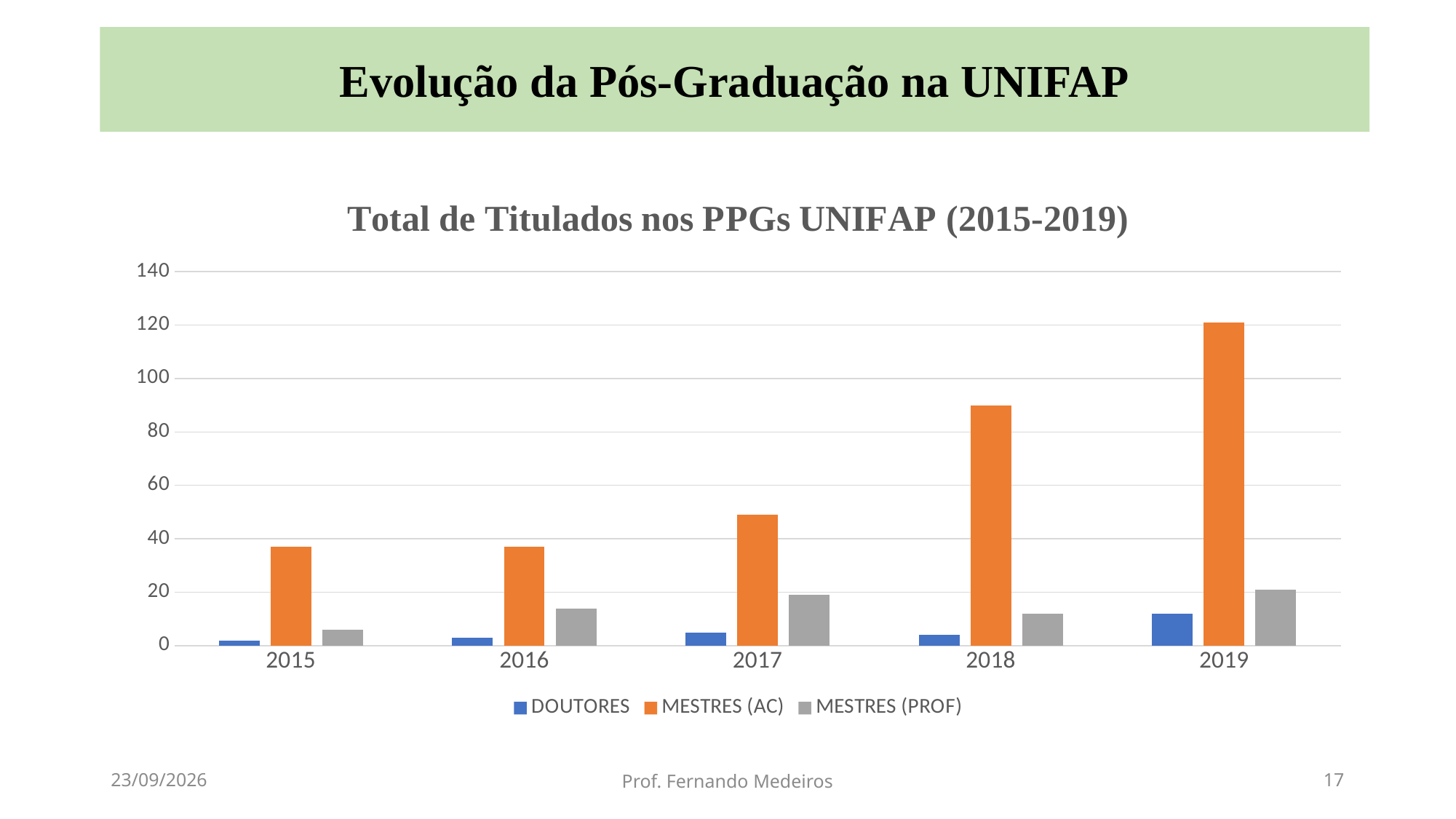
How many years are shown on the x axis of the chart? 5 In which year is the MESTRES (PROF) value lowest? 2015 How many series does the chart's legend list? 3 Do the MESTRES (AC) values generally rise or fall from 2015 to 2019? rise In which year is the MESTRES (AC) value highest? 2019 In which year is the DOUTORES value highest? 2019 Is the DOUTORES value for 2019 greater or less than 20? less What kind of chart is shown on the slide? bar chart Is the MESTRES (AC) value for 2019 greater or less than 100? greater Is the MESTRES (AC) value for 2017 greater or less than 60? less What is the title of the chart? Total de Titulados nos PPGs UNIFAP (2015-2019) Which is larger, the MESTRES (AC) value for 2018 or for 2017? 2018